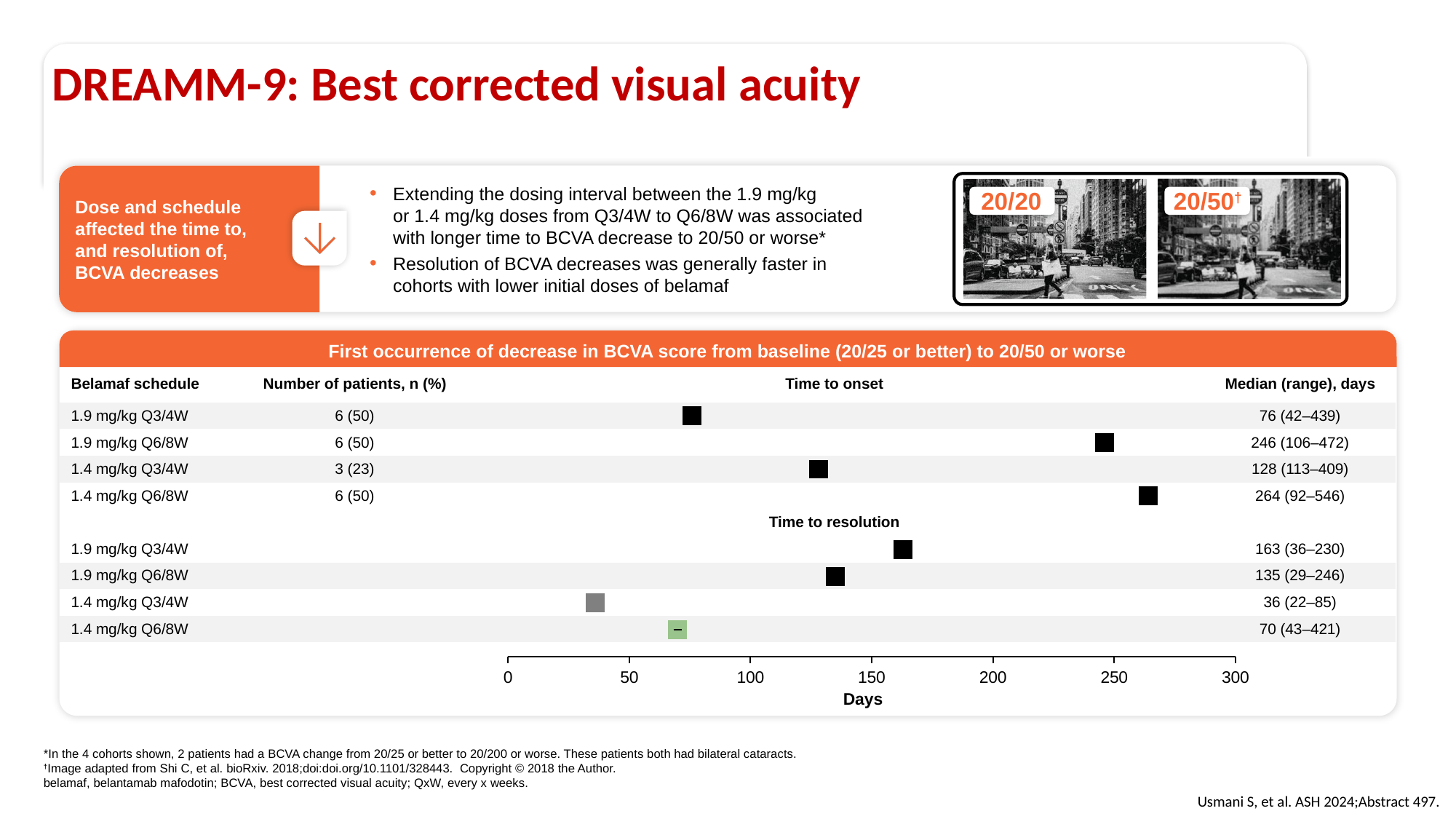
Which has a longer median time to resolution: 1.9 mg/kg Q3/4W or 1.9 mg/kg Q6/8W? 1.9 mg/kg Q3/4W What is the median (range) time to resolution in days for the 1.4 mg/kg Q3/4W cohort? 36 (22–85) How many patients (n, %) had a first occurrence of BCVA decrease in the 1.4 mg/kg Q3/4W cohort? 3 (23) How many belamaf schedules are shown in the Time to onset section? 4 What is the title of the table/chart? First occurrence of decrease in BCVA score from baseline (20/25 or better) to 20/50 or worse What is the difference in median time to onset (days) between the 1.9 mg/kg Q6/8W and 1.9 mg/kg Q3/4W cohorts? 170 What is the difference in median time to resolution (days) between the 1.4 mg/kg Q6/8W and 1.4 mg/kg Q3/4W cohorts? 34 Is the median time to onset for the 1.4 mg/kg Q3/4W cohort greater or less than 100 days? greater What is the maximum value shown on the Days axis? 300 What is the median time to onset (days) for the 1.9 mg/kg Q6/8W cohort? 246 Which belamaf schedule has the longest median time to onset? 1.4 mg/kg Q6/8W Which belamaf schedule has the shortest median time to resolution? 1.4 mg/kg Q3/4W